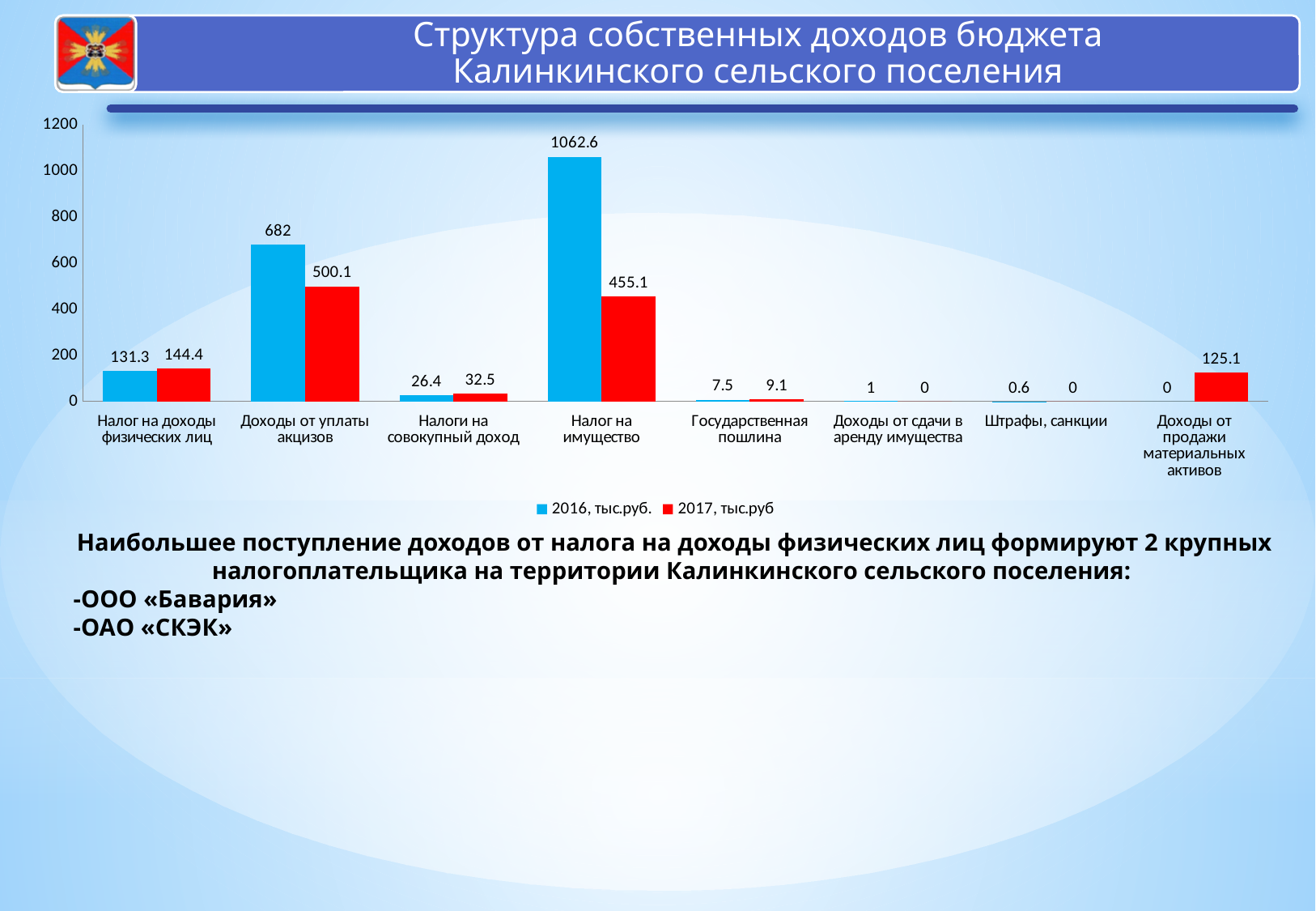
How many series does the legend list? 2 Is the 2016 value for Доходы от уплаты акцизов greater or less than 600? greater What kind of chart is shown on the slide? bar chart What is the 2016 value for Налог на имущество? 1062.6 What is the difference between the 2016 and 2017 values for Налог на имущество? 607.5 What is the 2017 value for Доходы от уплаты акцизов? 500.1 What is the 2017 value for Доходы от продажи материальных активов? 125.1 Which category has the highest 2017 value? Доходы от уплаты акцизов What colour represents the 2017 series in the chart? red Which category has the highest 2016 value? Налог на имущество How many categories are shown on the x axis? 8 Which is larger for Налог на доходы физических лиц: the 2016 value or the 2017 value? 2017